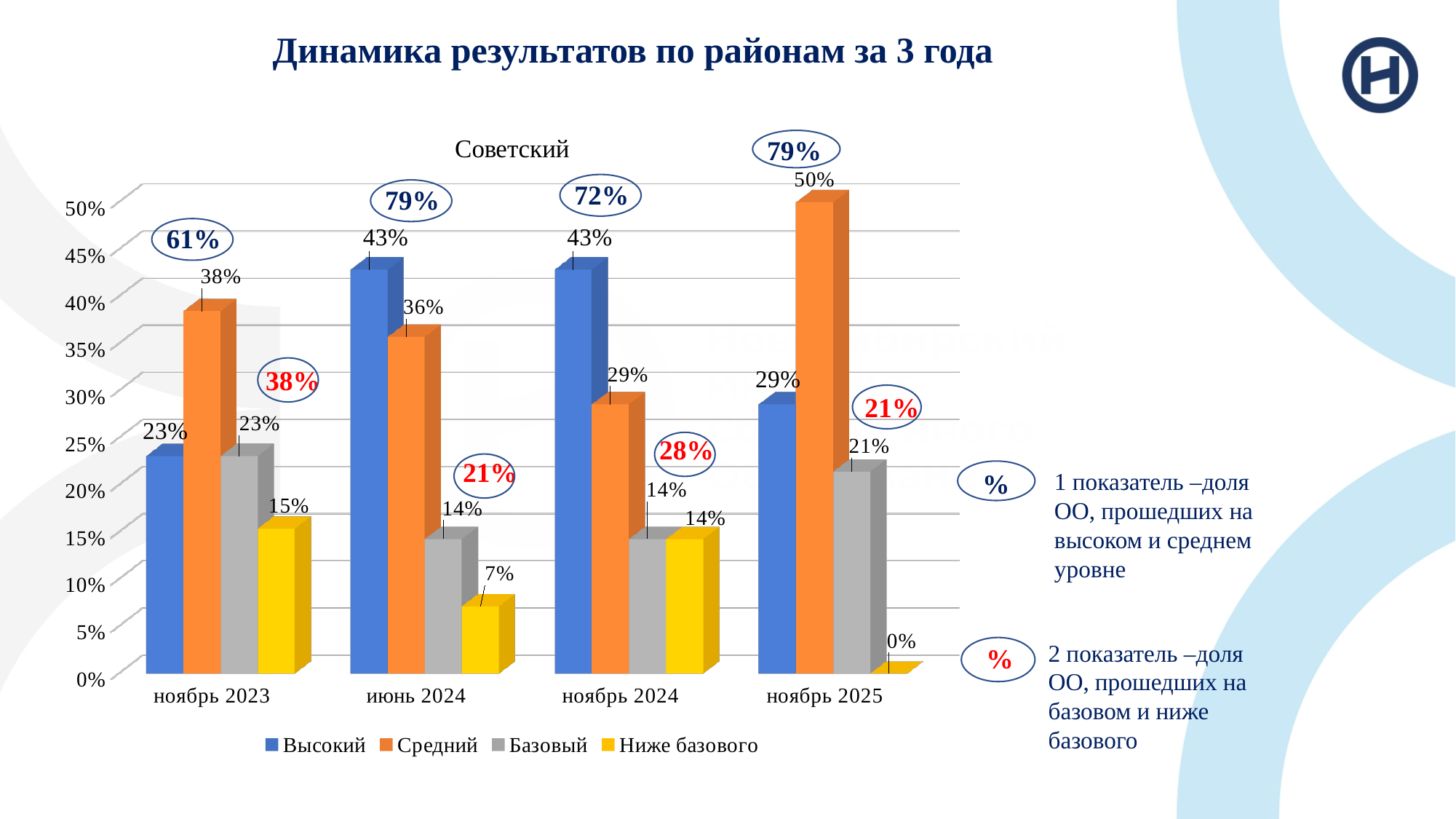
What is the value for Высокий in ноябрь 2024? 43% What is the value for Ниже базового in июнь 2024? 7% In which category does the Средний series reach its highest value? ноябрь 2025 What kind of chart is shown on the slide? bar chart In which category is the Ниже базового value lowest? ноябрь 2025 Which is larger in ноябрь 2023: the Высокий value or the Средний value? Средний What is the value for Средний in ноябрь 2025? 50% How many categories are shown on the x axis? 4 How many series does the legend list? 4 What is the value for Базовый in ноябрь 2023? 23% What is the difference between the Средний value in ноябрь 2025 and the Средний value in ноябрь 2024? 21% What is the title of the chart? Советский